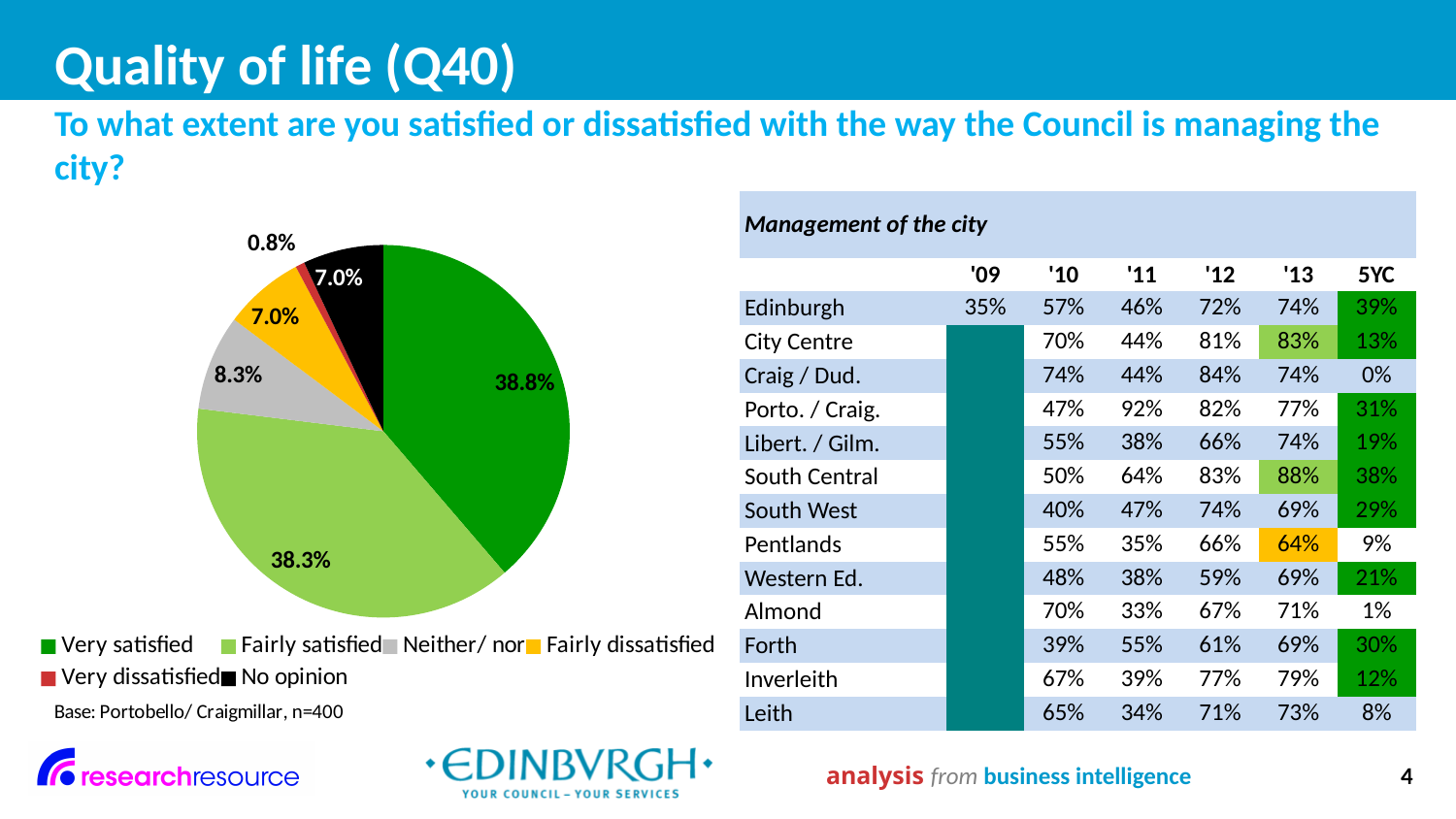
What type of chart is shown on the left of the slide? Pie chart How many slices does the pie chart have? 6 What percentage of the pie chart is labelled Fairly satisfied? 38.3% Which category has the largest slice of the pie chart? Very satisfied What percentage of the pie chart is labelled Very dissatisfied? 0.8% Which category has the smallest slice of the pie chart? Very dissatisfied What is the combined percentage of the Fairly dissatisfied and Very dissatisfied slices? 7.8% Which slice is larger in the pie chart: Very satisfied or Neither/ nor? Very satisfied What is the base (sample size) stated below the pie chart legend? Portobello/ Craigmillar, n=400 What percentage of the pie chart is labelled Very satisfied? 38.8% What is the difference in percentage points between the Very satisfied and Fairly satisfied slices? 0.5 What percentage of the pie chart is labelled Neither/ nor? 8.3%